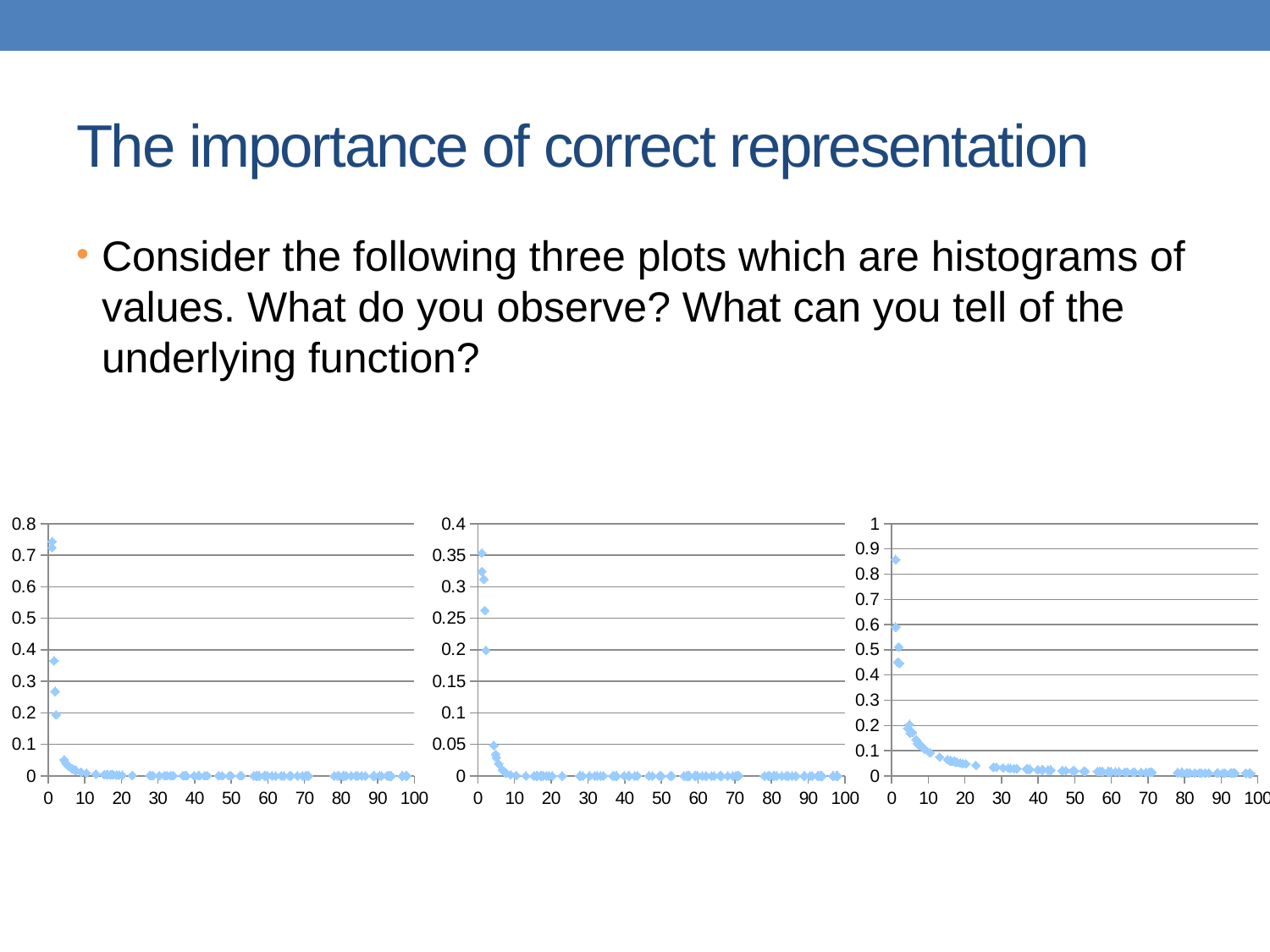
In the middle chart, is the highest plotted value greater or less than 0.3? greater What kind of chart is the left chart on the slide? scatter chart What is the maximum value shown on the y axis of the middle chart? 0.4 In the left chart, do the plotted values rise or fall as x increases from 0 to 100? fall Which chart has the higher maximum plotted value, the left chart or the right chart? the right chart In the right chart, is the highest plotted value greater or less than 0.8? greater In the left chart, is the highest plotted value greater or less than 0.7? greater In the middle chart, do the plotted values rise or fall as x increases? fall How many charts are shown on the slide? 3 In the right chart, do the plotted values rise or fall as x increases? fall